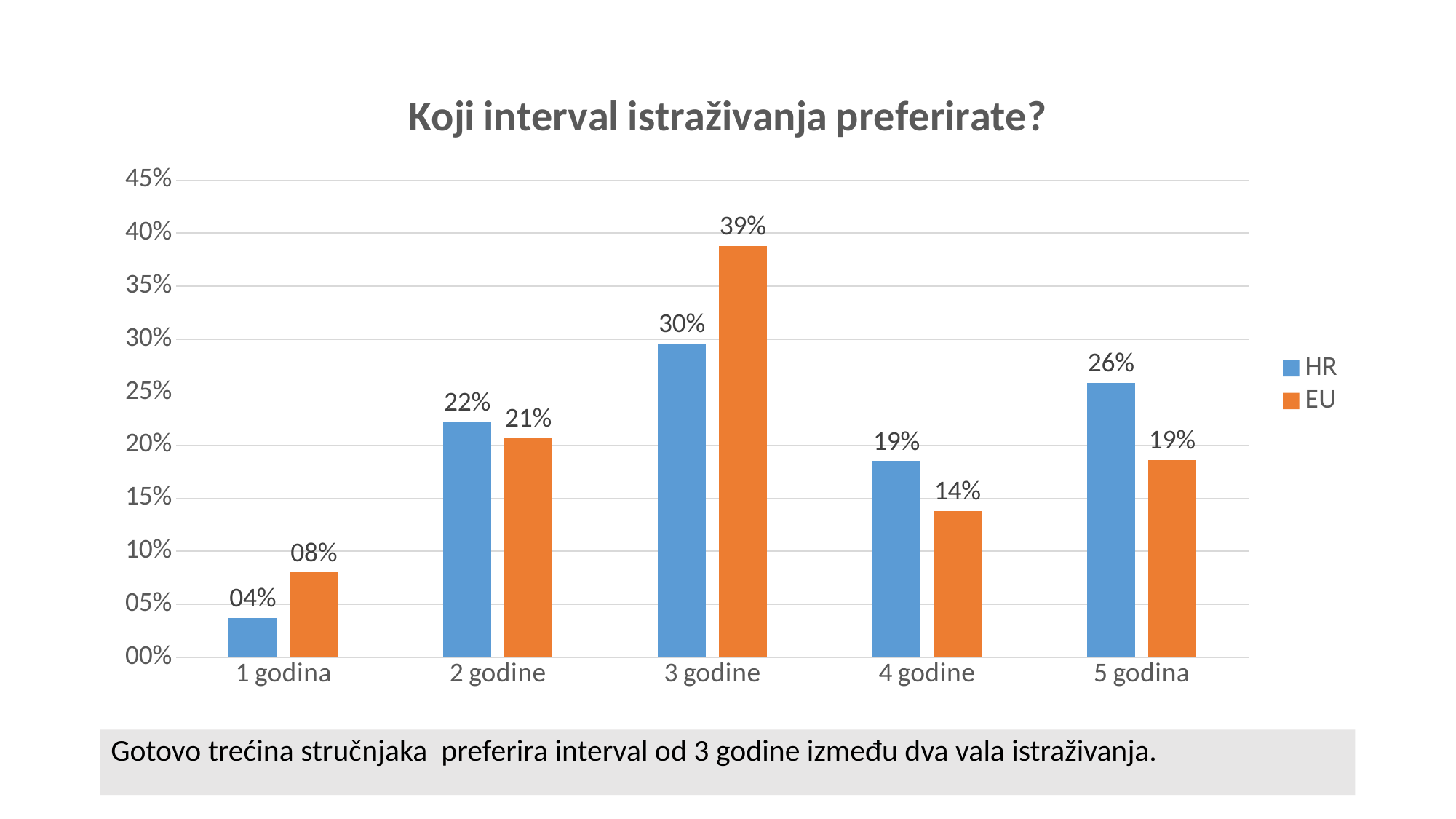
What kind of chart is shown on the slide? bar chart What is the EU value for 4 godine? 14% Which category has the lowest HR value? 1 godina What is the difference between the EU and HR values for 3 godine? 9% How many series does the legend list? 2 What is the HR value for 3 godine? 30% Which is larger for 5 godina, the HR value or the EU value? HR Which category has the highest EU value? 3 godine What is the title of the chart? Koji interval istraživanja preferirate? Which colour represents the EU series? orange What is the EU value for 1 godina? 08% How many categories are shown on the x axis? 5